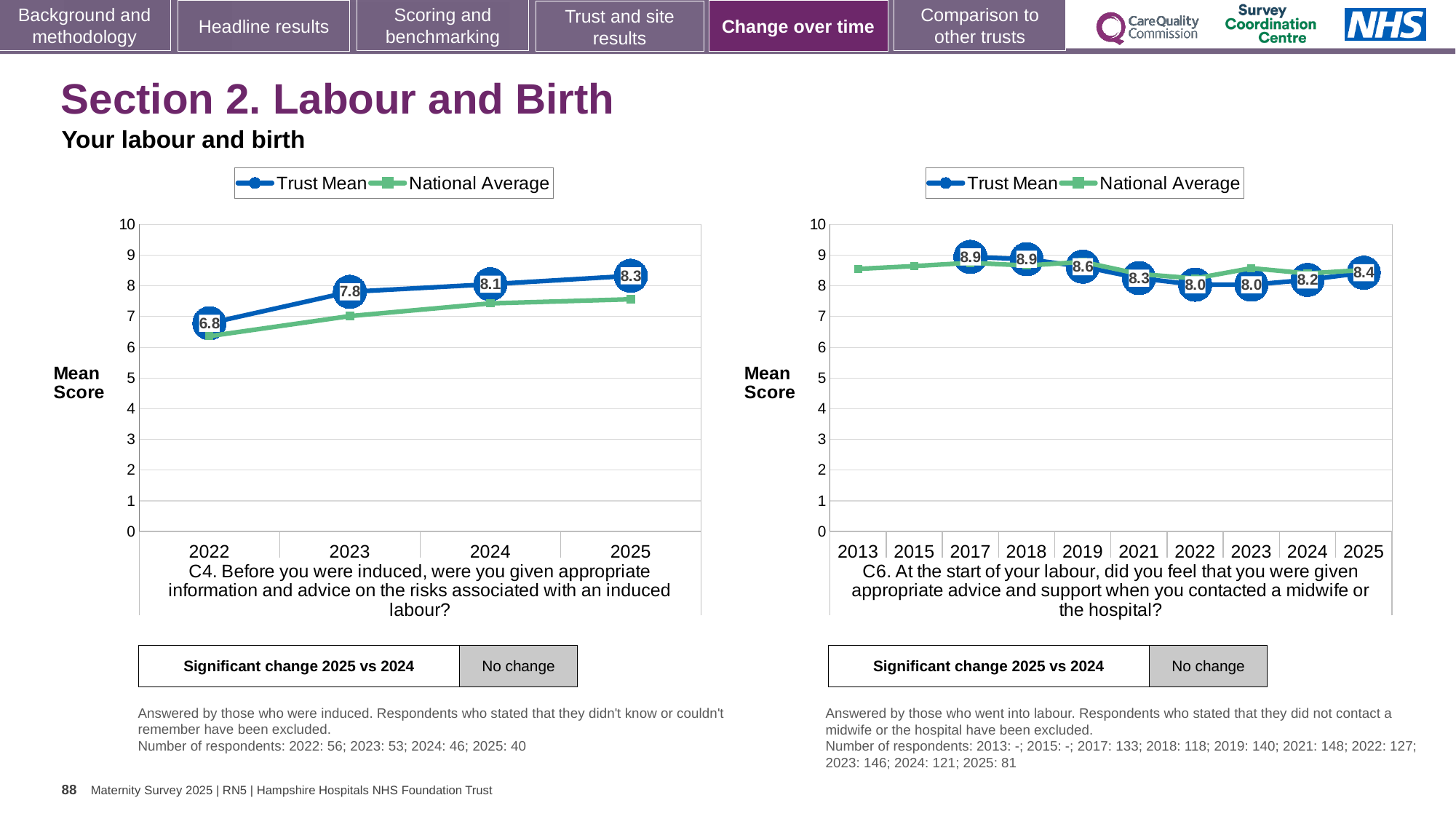
In the right chart (C6), what is the difference between the Trust Mean for 2018 and for 2021? 0.6 In the left chart (C4), what is the Trust Mean for 2022? 6.8 In the right chart (C6), what is the Trust Mean for 2019? 8.6 In the left chart (C4), does the Trust Mean rise or fall from 2022 to 2025? rise In the left chart (C4), by how much did the Trust Mean change from 2022 to 2025? 1.5 In the right chart (C6), which is larger, the Trust Mean for 2017 or for 2022? 2017 In the right chart (C6), what is the Trust Mean for 2025? 8.4 How many years are shown on the x axis of the right chart (C6)? 10 In the left chart (C4), which year has the lowest Trust Mean? 2022 How many series does the legend of the left chart (C4) list? 2 In the left chart (C4), is the National Average for 2022 greater or less than 7? less In the left chart (C4), what is the Trust Mean for 2025? 8.3